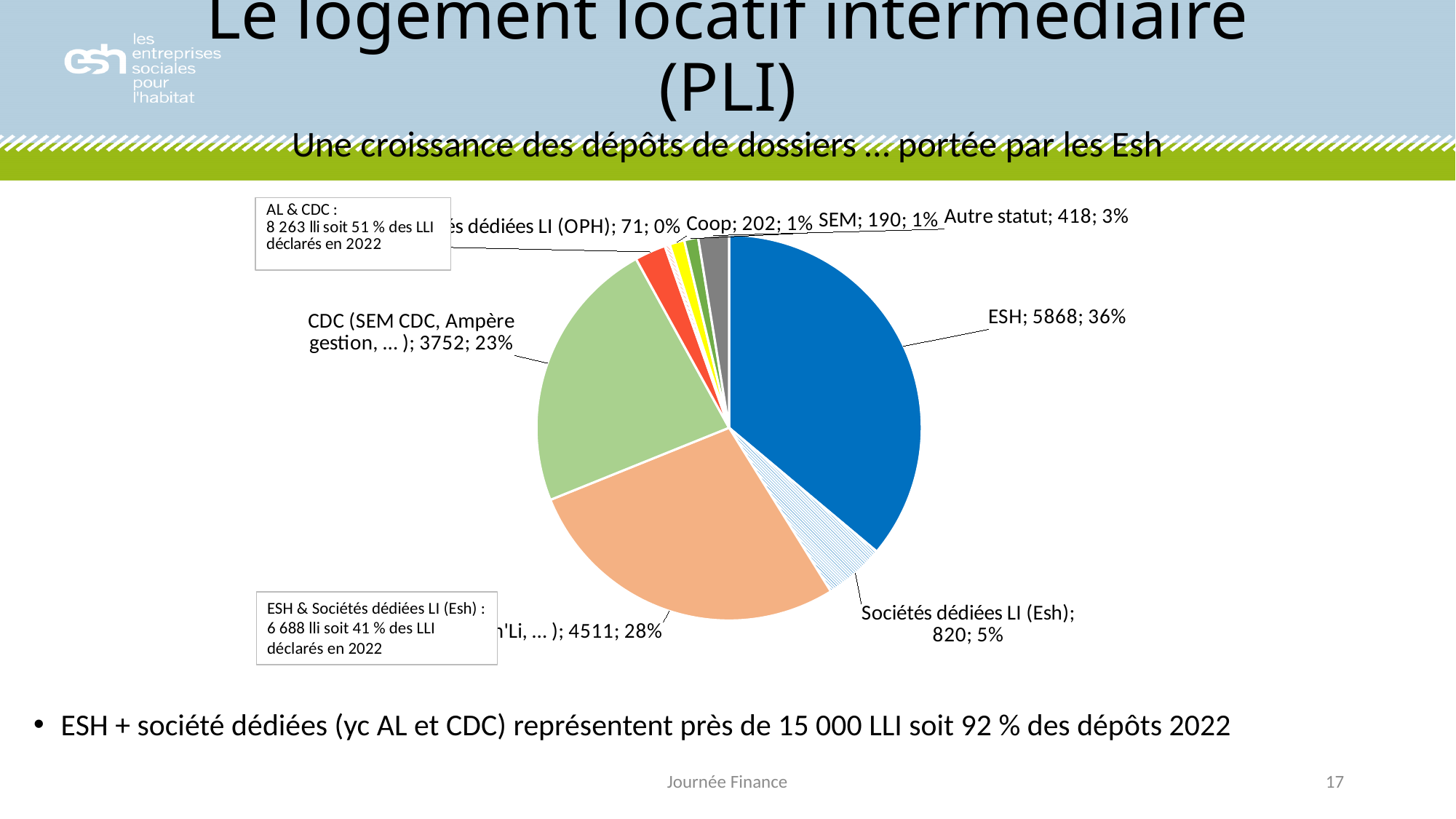
What share of the pie does the ESH slice represent? 36% Which slice of the pie chart has the largest value? ESH Which is larger, the Coop slice or the SEM slice? Coop What is the difference between the ESH value and the CDC (SEM CDC, Ampère gestion, ...) value? 2116 What is the value shown for the ESH slice of the pie chart? 5868 What is the value shown for the Coop slice? 202 How many slices does the pie chart have? 9 What share of the pie does the CDC (SEM CDC, Ampère gestion, ...) slice represent? 23% What is the value shown for the Autre statut slice? 418 What is the value shown for the Sociétés dédiées LI (Esh) slice? 820 What kind of chart is shown on the slide? Pie chart What is the value shown for the CDC (SEM CDC, Ampère gestion, ...) slice? 3752